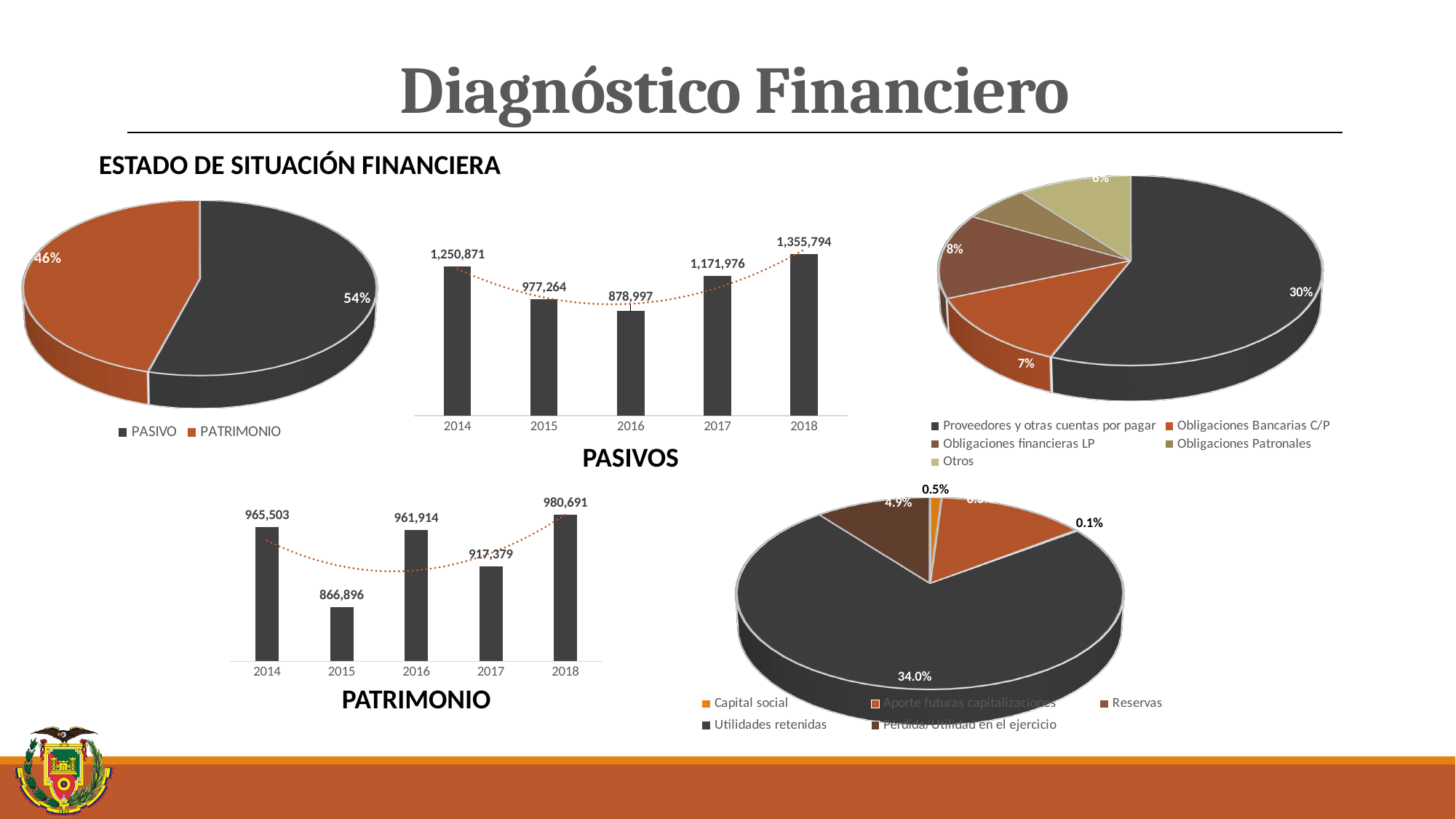
In the PATRIMONIO bar chart, which year has the highest value? 2018 In the PASIVOS bar chart, what is the value for 2018? 1,355,794 What kind of chart is the PASIVOS chart? Bar chart In the PASIVOS bar chart, what is the difference between the 2018 and 2016 values? 476,797 In the PATRIMONIO bar chart, which is larger, the value for 2014 or the value for 2017? 2014 In the PATRIMONIO bar chart, what is the value for 2015? 866,896 How many entries does the legend of the top-right pie chart list? 5 In the PATRIMONIO bar chart, what is the difference between the 2018 and 2015 values? 113,795 In the top-left pie chart, which slice is larger, PASIVO or PATRIMONIO? PASIVO In the PASIVOS bar chart, which year has the lowest value? 2016 In the PASIVOS bar chart, how many years are shown on the x axis? 5 In the top-left pie chart, what share does PASIVO have? 54%